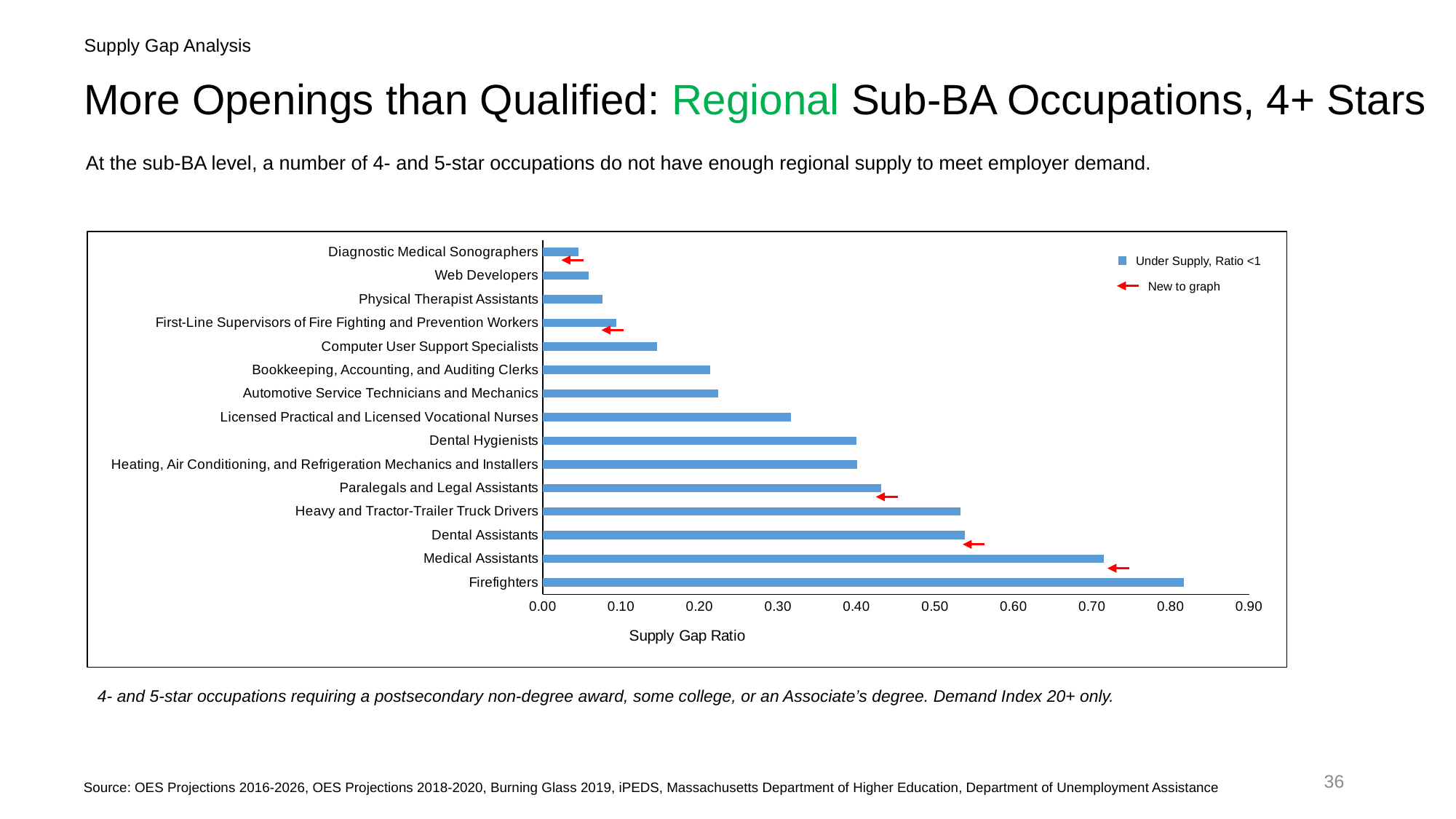
Which occupation has the highest Supply Gap Ratio? Firefighters Is the Supply Gap Ratio for Licensed Practical and Licensed Vocational Nurses greater or less than 0.40? less How many occupations are marked with a red arrow as new to the graph? 5 Which has a higher Supply Gap Ratio, Computer User Support Specialists or Physical Therapist Assistants? Computer User Support Specialists How many occupations are plotted in the chart? 15 What is the title of the x axis of the chart? Supply Gap Ratio Which has a higher Supply Gap Ratio, Firefighters or Medical Assistants? Firefighters Is the Supply Gap Ratio for Physical Therapist Assistants greater or less than 0.10? less What kind of chart is shown on the slide? Bar chart Is the Supply Gap Ratio for Medical Assistants greater or less than 0.60? greater